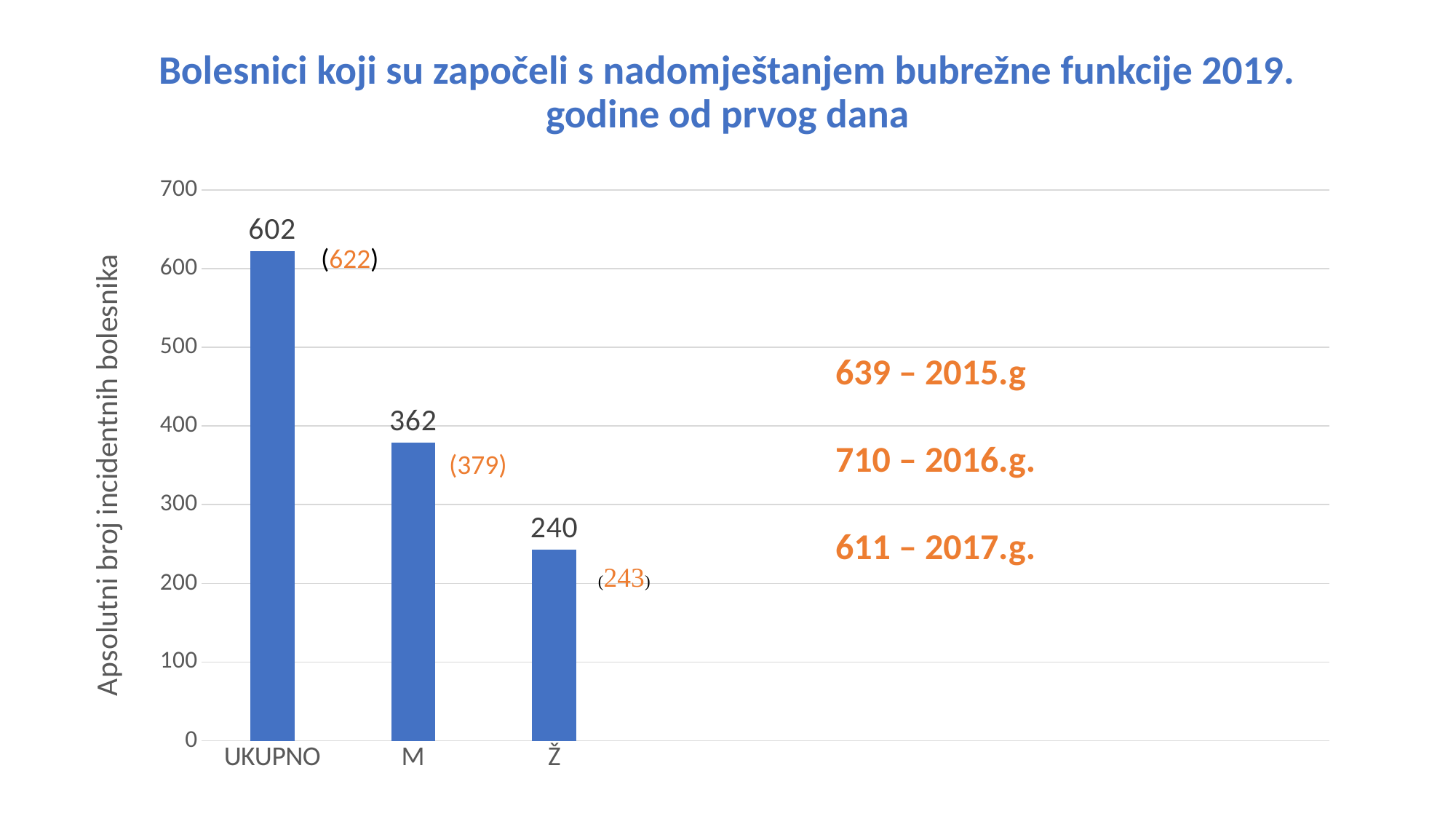
Which category has the lowest value? Ž What kind of chart is shown on the slide? bar chart How many categories are shown on the x axis? 3 Is the value for UKUPNO greater or less than 500? greater What is the label of the vertical axis? Apsolutni broj incidentnih bolesnika Which is larger, the value for M or the value for Ž? M Which category has the highest value? UKUPNO